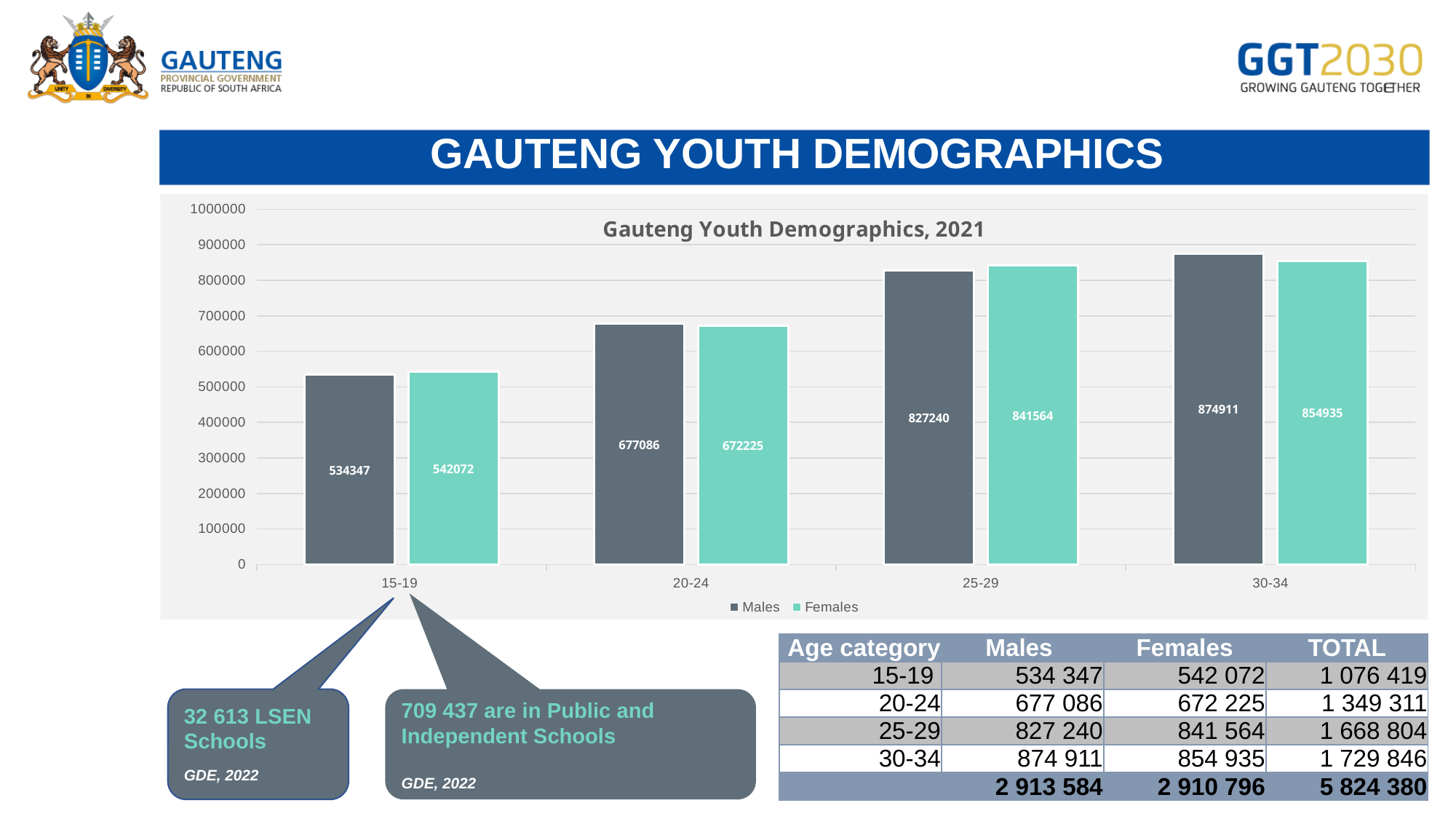
What is the title of the chart? Gauteng Youth Demographics, 2021 How many series does the legend list? 2 How many age categories are shown on the x axis? 4 Which age category has the lowest value for Males? 15-19 What kind of chart is shown on the slide? bar chart Is the value for Females in the 20-24 age category greater or less than 700000? less Which is larger in the 25-29 age category, Males or Females? Females What is the value for Males in the 15-19 age category? 534347 What is the difference between Males and Females in the 20-24 age category? 4861 Which age category has the highest value for Females? 30-34 What is the value for Females in the 25-29 age category? 841564 What is the value for Males in the 30-34 age category? 874911